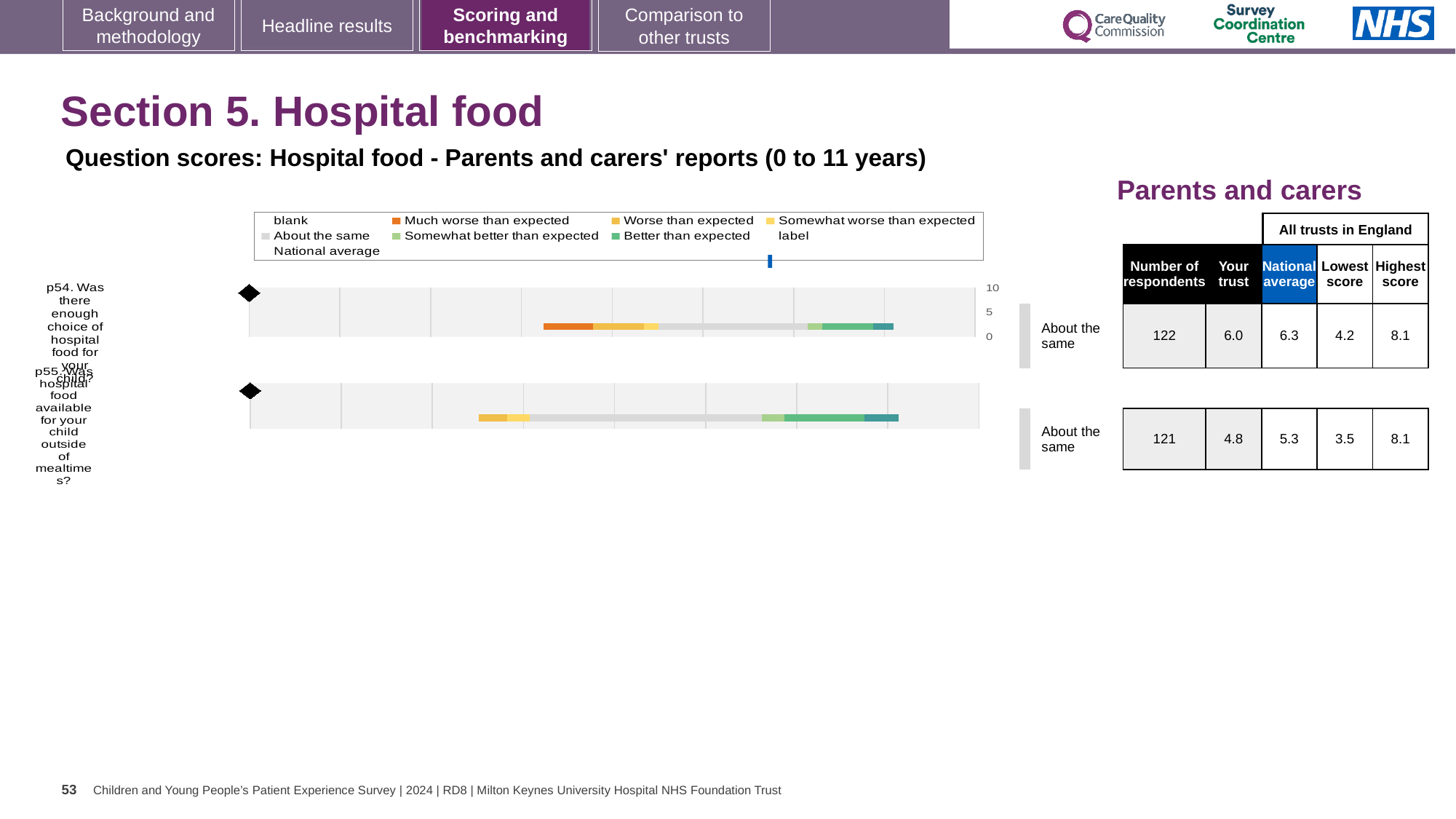
How many respondents answered p54? 122 What is the national average score for p55 (hospital food available outside of mealtimes)? 5.3 What is the difference between the national average and the 'Your trust' score for p55? 0.5 What is the 'Your trust' score for p54 (enough choice of hospital food)? 6.0 Which legend entry is shown in orange? Much worse than expected How many questions (bars) are plotted in the hospital food chart? 2 What is the difference between the highest and lowest scores across all trusts in England for p54? 3.9 What is the highest value shown on the chart's axis? 10 What benchmark category is the trust given for p55? About the same What kind of chart is used to show the question scores for hospital food? bar chart Which is larger for p54: the 'Your trust' score or the national average? National average What is the lowest score among all trusts in England for p55? 3.5